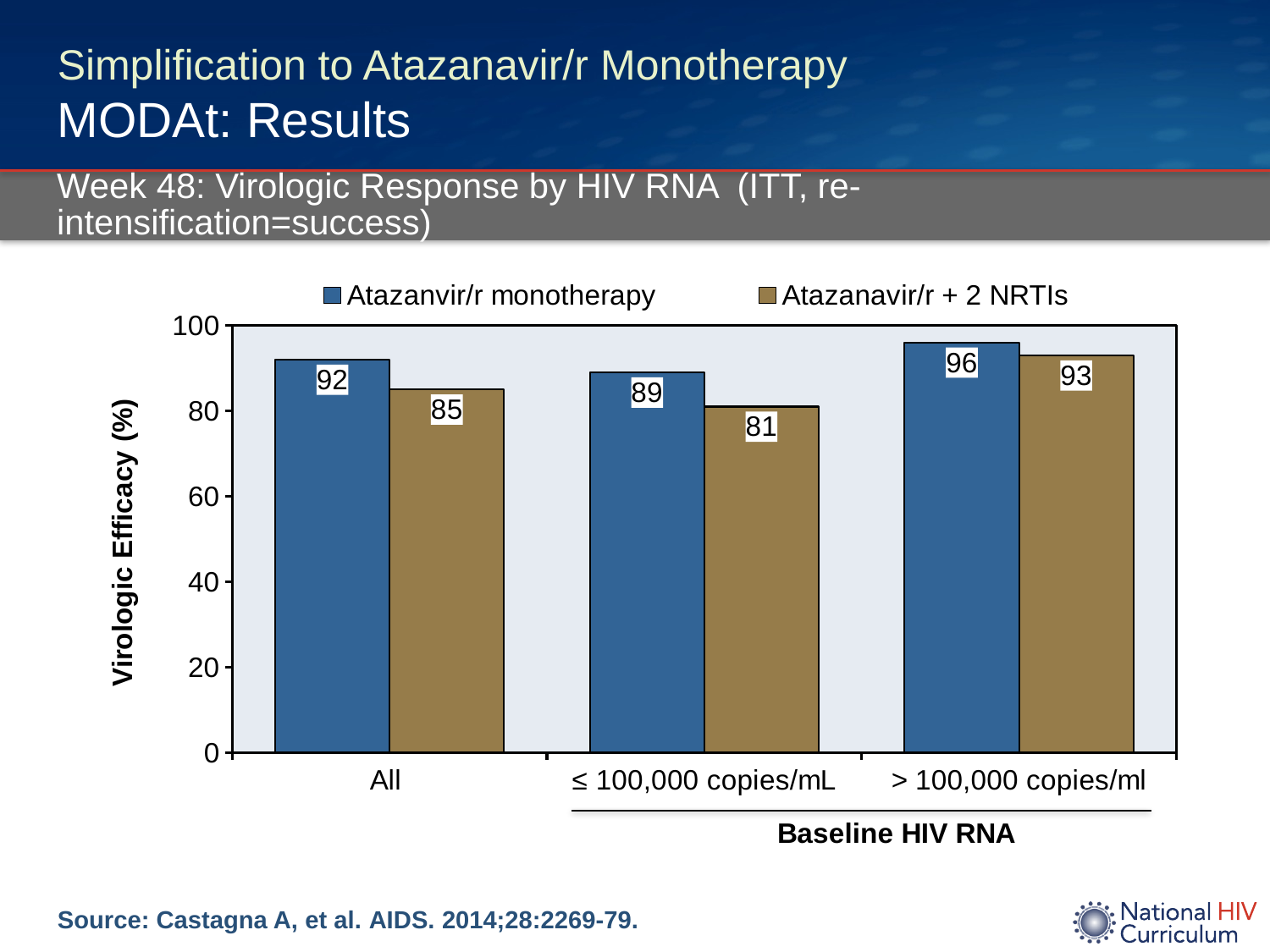
What is the difference between Atazanvir/r monotherapy and Atazanavir/r + 2 NRTIs in the ≤ 100,000 copies/mL group? 8 Which baseline HIV RNA category has the highest value for Atazanvir/r monotherapy? > 100,000 copies/ml What kind of chart is shown on the slide? Bar chart How many series does the legend list? 2 What is the virologic efficacy for Atazanavir/r + 2 NRTIs in the > 100,000 copies/ml group? 93 What is the virologic efficacy for Atazanavir/r + 2 NRTIs in the ≤ 100,000 copies/mL group? 81 Which category has the lowest value for Atazanavir/r + 2 NRTIs? ≤ 100,000 copies/mL What is the virologic efficacy for Atazanvir/r monotherapy in the All group? 92 What is the y-axis label of the chart? Virologic Efficacy (%) How many categories are shown on the x axis? 3 In the > 100,000 copies/ml group, which series has the larger value? Atazanvir/r monotherapy What is the difference between Atazanvir/r monotherapy and Atazanavir/r + 2 NRTIs in the All group? 7